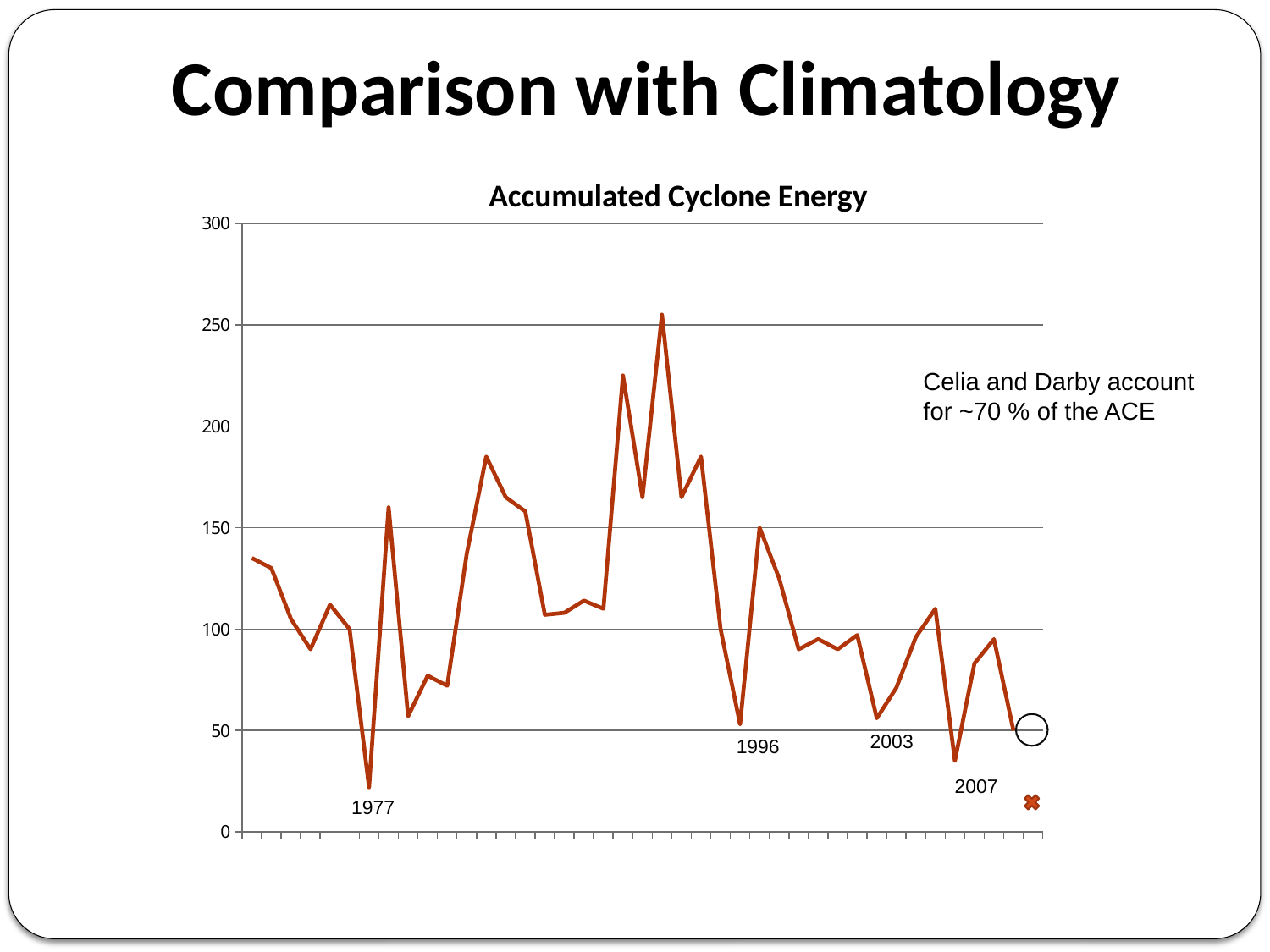
What is the title of the chart? Accumulated Cyclone Energy Which has the lower value, 1977 or 1996? 1977 Is the value for 2007 greater or less than 50? less What is the maximum value shown on the vertical axis? 300 Is the value for 2003 greater or less than 100? less Is the highest point on the line greater or less than 200? greater Which has the lower value, 1977 or 2007? 1977 What kind of chart is shown on the slide? line chart